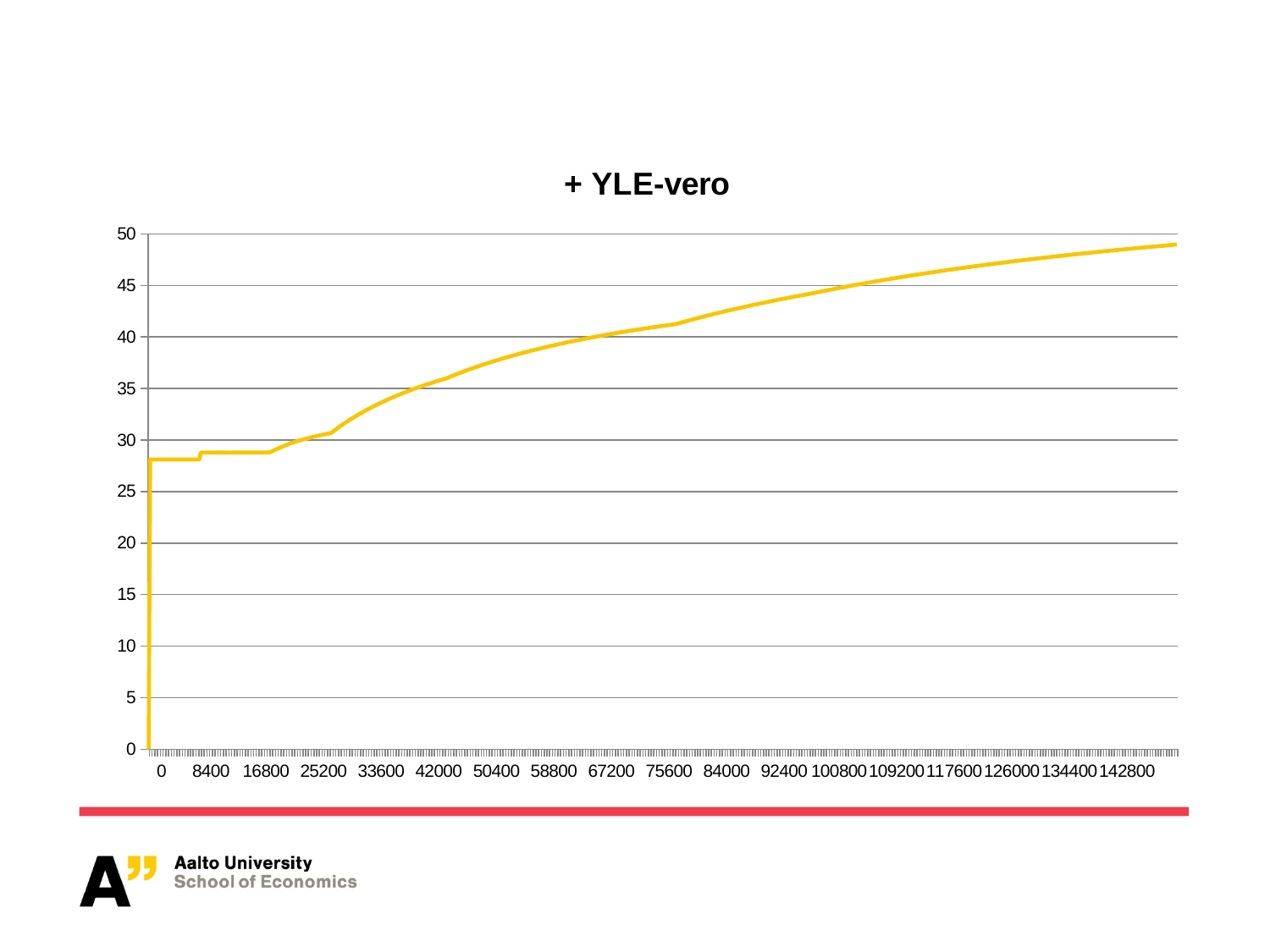
Is the value at x = 8400 greater or less than 30? less Is the value at x = 117600 greater or less than 45? greater Is the value at x = 142800 greater or less than 50? less Do the values on the chart generally rise or fall as the x axis increases? rise What is the title of the chart? + YLE-vero Which is larger, the value at x = 142800 or the value at x = 8400? 142800 What is the highest value shown on the y axis? 50 What kind of chart is shown on the slide? line chart